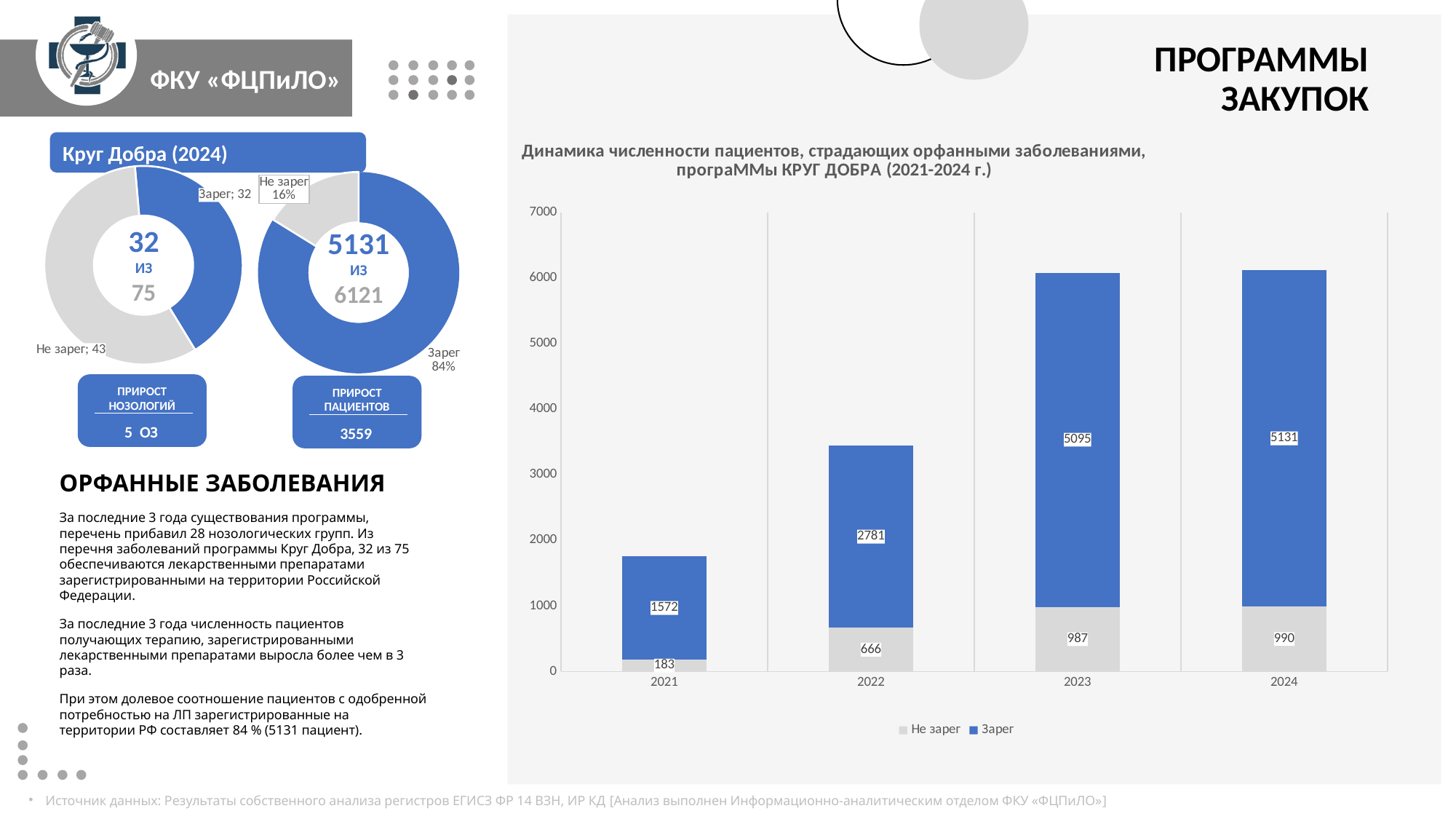
In the right donut chart under 'Круг Добра (2024)', what share does 'Зарег' have? 84% In the bar chart 'Динамика численности пациентов...', what is the total of the stacked bar for 2024? 6121 In the bar chart 'Динамика численности пациентов...', what is the value of 'Зарег' for 2023? 5095 What kind of chart is the chart titled 'Динамика численности пациентов...'? Stacked bar chart In the bar chart 'Динамика численности пациентов...', how many series does the legend list? 2 In the bar chart 'Динамика численности пациентов...', which year has the highest 'Зарег' value? 2024 In the left donut chart under 'Круг Добра (2024)', what is the value for 'Не зарег'? 43 In the bar chart 'Динамика численности пациентов...', how many years are shown on the x axis? 4 In the bar chart 'Динамика численности пациентов...', what is the value of 'Не зарег' for 2022? 666 In the bar chart 'Динамика численности пациентов...', what is the difference between the 'Зарег' values for 2024 and 2023? 36 In the bar chart 'Динамика численности пациентов...', does the 'Зарег' value rise or fall from 2021 to 2024? Rises In the bar chart 'Динамика численности пациентов...', which year has the lowest 'Не зарег' value? 2021